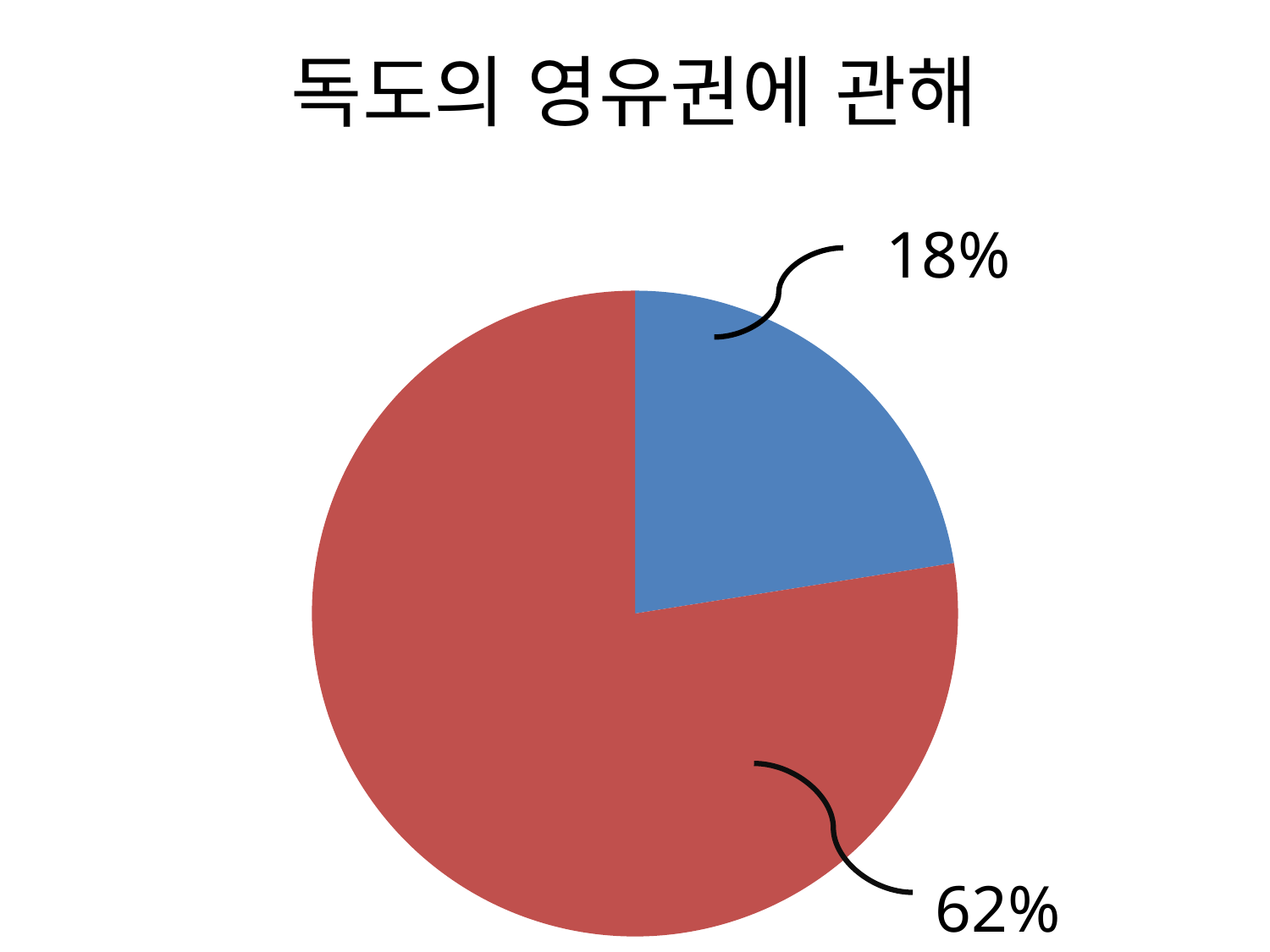
Which is larger, the blue slice or the red slice? the red slice What is the title of the chart? 독도의 영유권에 관해 What colour is the slice labelled 62%? red Which slice of the pie chart is the largest? the red slice (62%) What kind of chart is shown on the slide? pie chart What share of the pie is labelled for the blue slice? 18% How many slices does the pie chart have? 2 What value is labelled on the blue slice of the pie chart? 18% Which slice of the pie chart is the smallest? the blue slice (18%) What is the difference between the red slice's value and the blue slice's value? 44% What value is labelled on the red slice of the pie chart? 62%